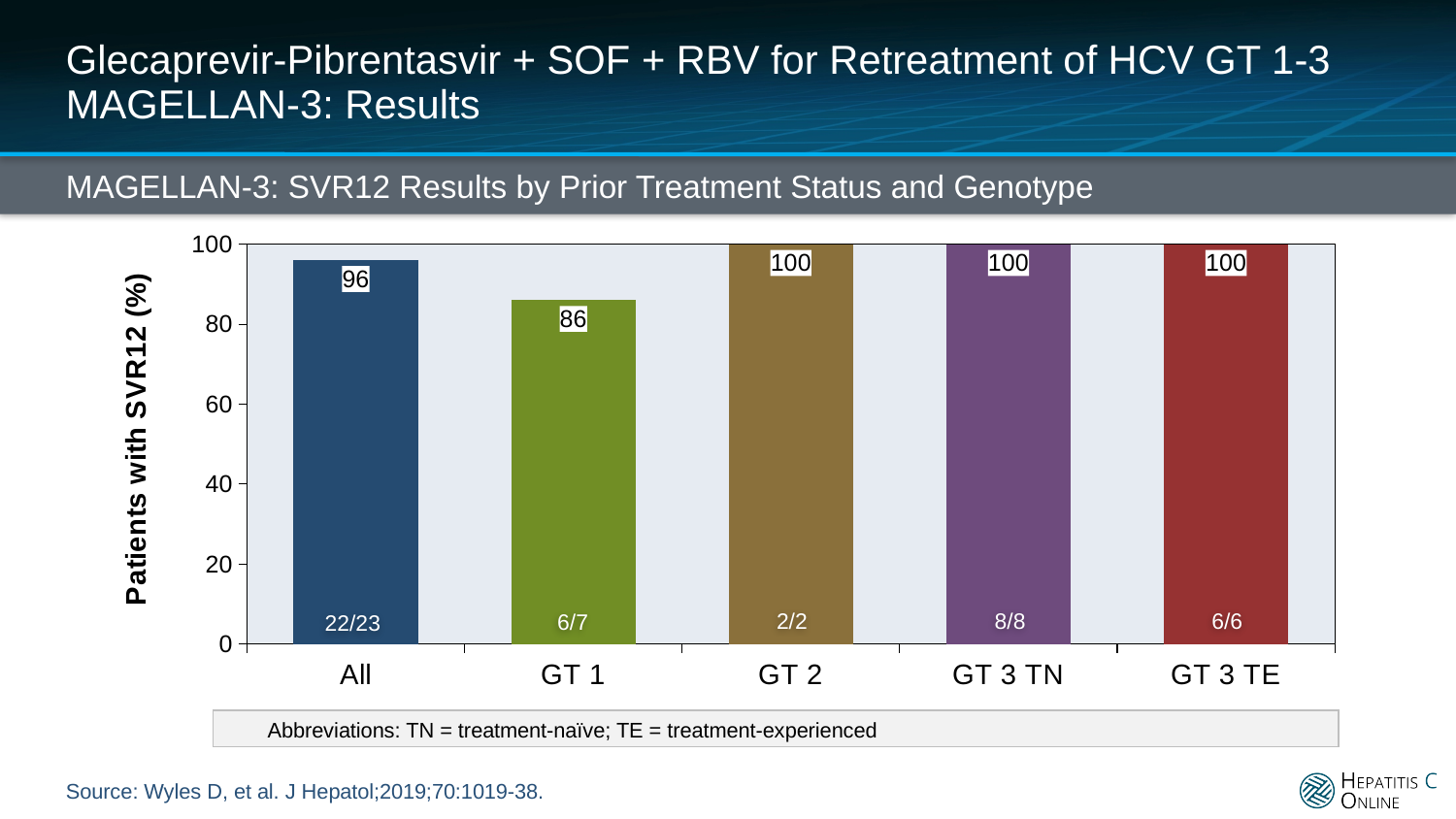
What is the label of the y axis? Patients with SVR12 (%) What fraction of patients is shown inside the GT 1 bar? 6/7 How many categories are shown on the x axis? 5 What is the SVR12 rate for GT 1? 86 What is the SVR12 rate for the All group? 96 What kind of chart is shown on the slide? Bar chart Which has a higher SVR12 rate, All or GT 1? All What fraction of patients is shown inside the All bar? 22/23 Is the SVR12 rate for GT 1 greater or less than 80? greater What is the SVR12 rate for GT 3 TN? 100 What is the difference in SVR12 rate between GT 2 and GT 1? 14 Which category has the lowest SVR12 rate? GT 1